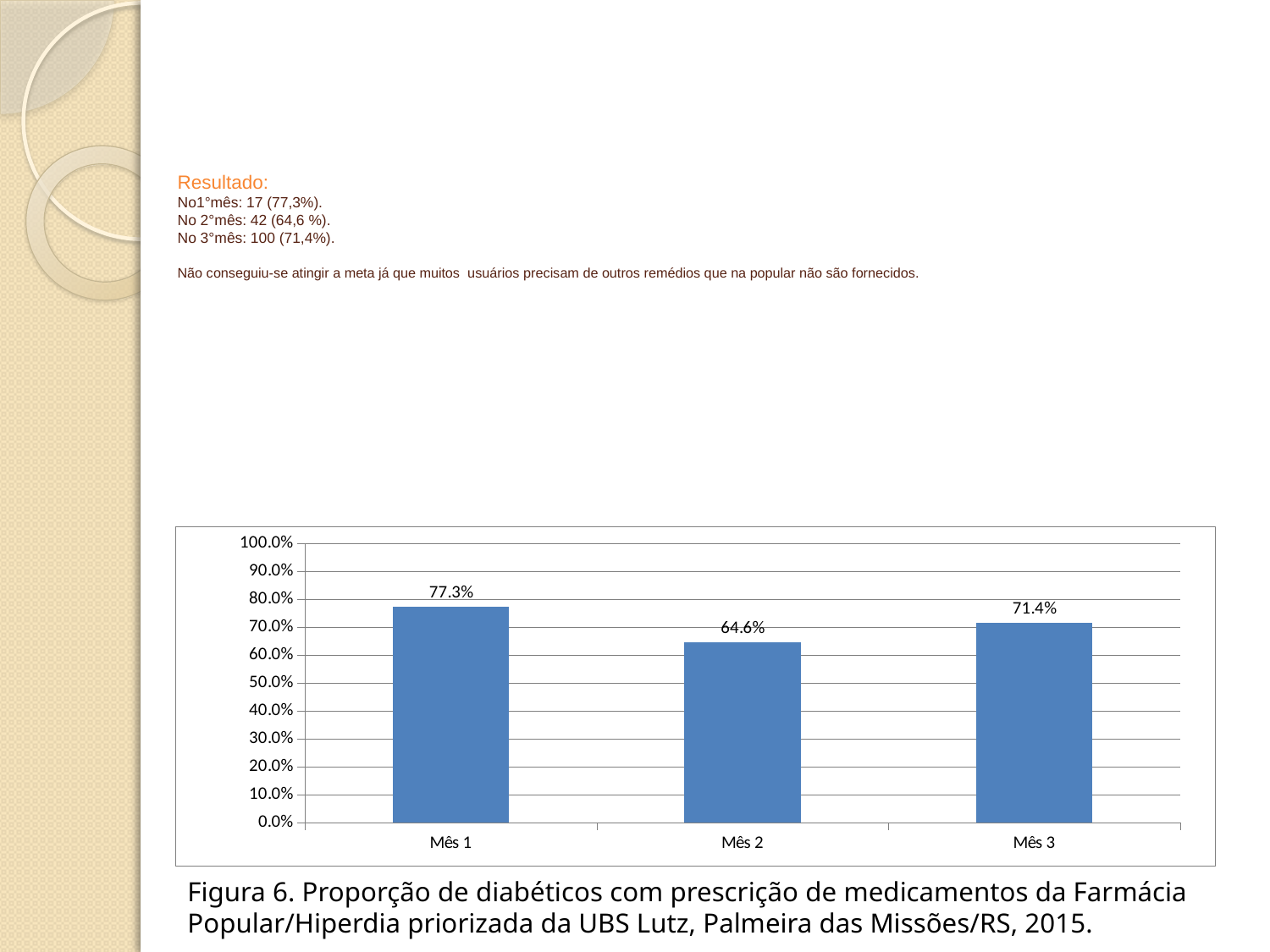
How many months are shown on the x axis? 3 What is the difference between the values for Mês 1 and Mês 2? 12.7% Which month has the lowest value? Mês 2 What is the highest value shown on the y axis? 100.0% Is the value for Mês 2 greater or less than 70.0%? less Which is larger, the value for Mês 1 or the value for Mês 3? Mês 1 What is the value for Mês 2? 64.6% What is the value for Mês 3? 71.4% What kind of chart is shown on the slide? bar chart What is the value for Mês 1? 77.3% What is the difference between the values for Mês 3 and Mês 2? 6.8% Which month has the highest value? Mês 1